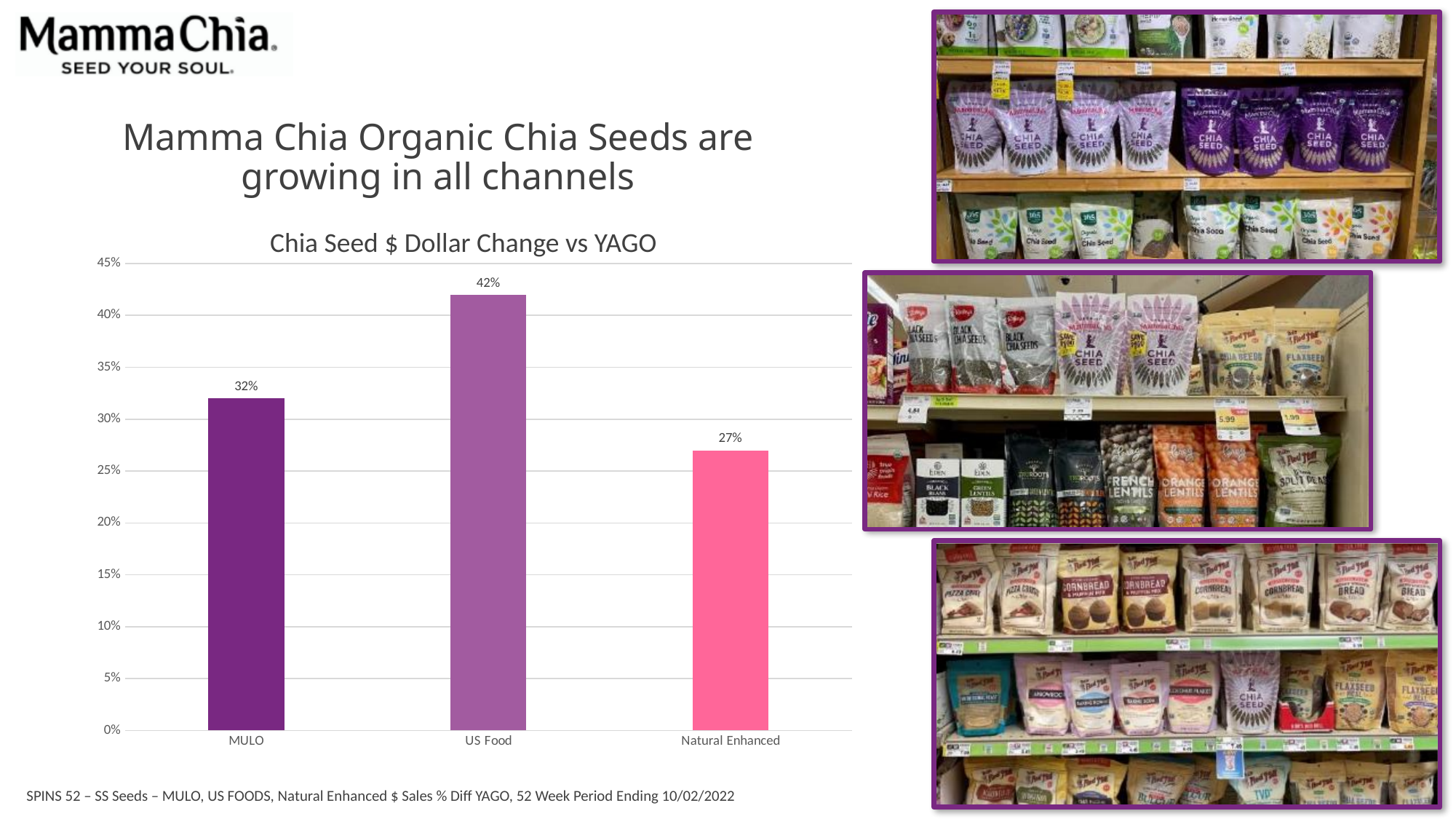
What is the value for Natural Enhanced in the chart? 27% Which channel has the highest dollar change vs YAGO? US Food What is the difference between the US Food and MULO values? 10% How many channels are shown in the chart? 3 What is the difference between the MULO and Natural Enhanced values? 5% Is the value for US Food greater or less than 40%? greater What kind of chart is shown on the slide? bar chart Which is larger, the value for MULO or the value for Natural Enhanced? MULO What is the value for US Food in the chart? 42% What is the value for MULO in the Chia Seed $ Dollar Change vs YAGO chart? 32% What is the title of the chart? Chia Seed $ Dollar Change vs YAGO Which channel has the lowest dollar change vs YAGO? Natural Enhanced